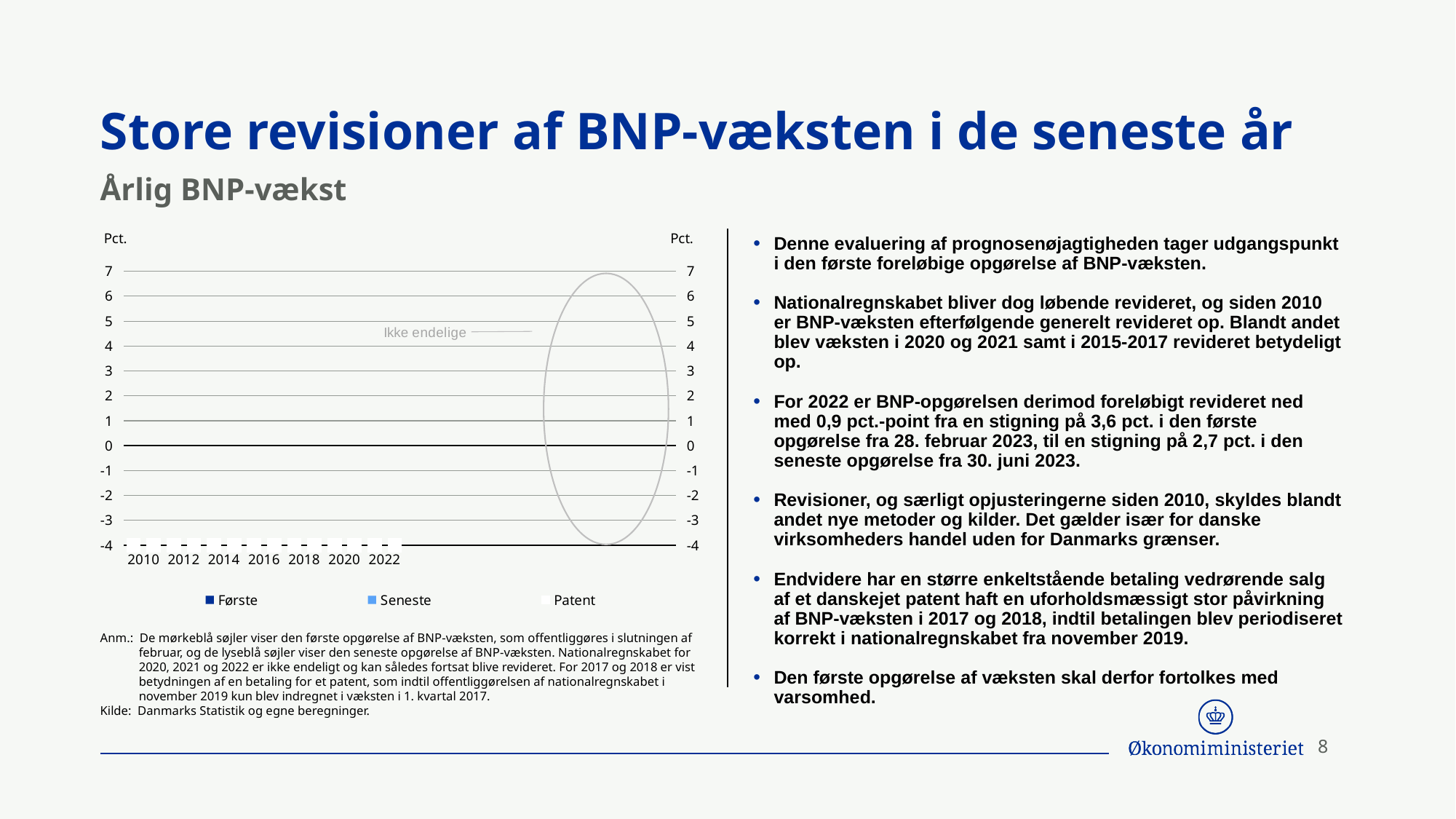
How many year labels are shown on the x axis of the chart? 7 What is the first year label on the x axis of the chart? 2010 What is the highest value shown on the chart's y axis? 7 What is the title of the chart? Årlig BNP-vækst What kind of chart is shown on the slide? Bar chart What is the lowest value shown on the chart's y axis? -4 What are the three series named in the chart legend? Første, Seneste, Patent What is the last year label on the x axis of the chart? 2022 How many series does the chart legend list? 3